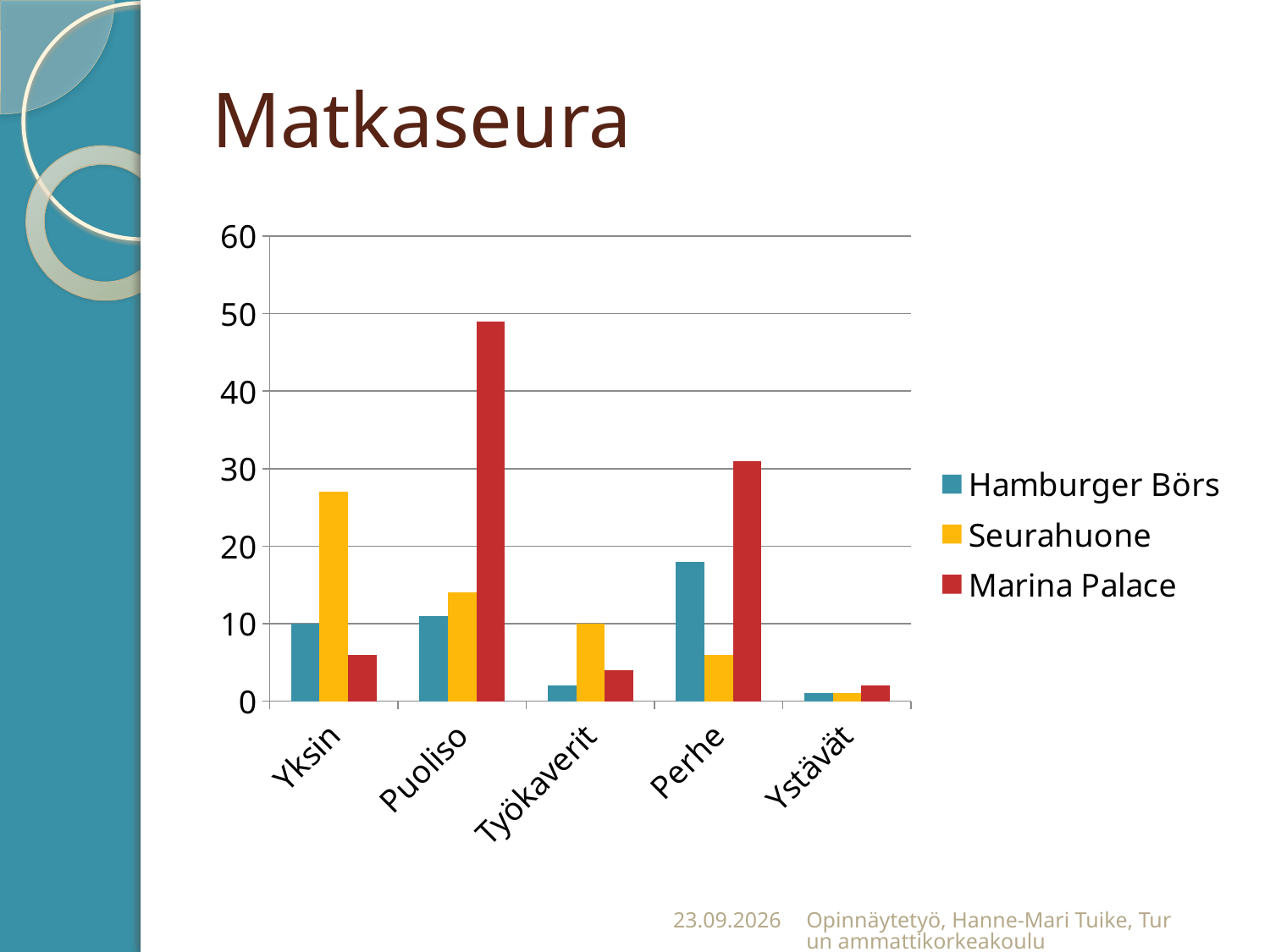
What is the value for Hamburger Börs in the Yksin category? 10 What is the value for Seurahuone in the Työkaverit category? 10 How many categories are shown on the x axis? 5 What is the title of the chart? Matkaseura Which is larger in the Yksin category: Seurahuone or Marina Palace? Seurahuone Which category has the highest value for Marina Palace? Puoliso How many series does the legend list? 3 Is the value for Marina Palace in the Puoliso category greater or less than 40? greater What kind of chart is shown on the slide? bar chart Is the value for Marina Palace in the Perhe category greater or less than 30? greater Which category has the highest value for Seurahuone? Yksin Which category has the highest value for Hamburger Börs? Perhe